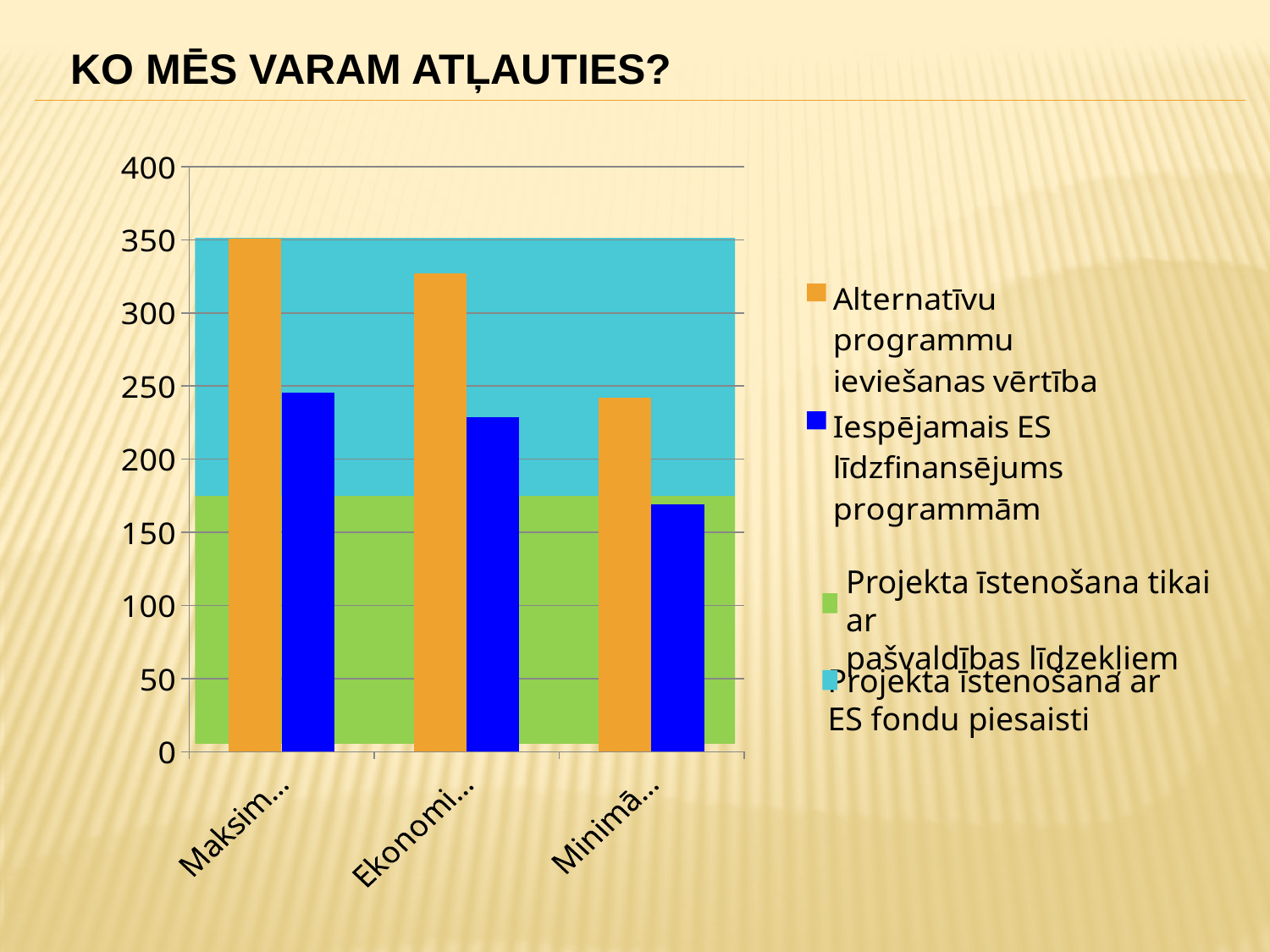
Is the blue bar for the rightmost category greater or less than 200? less Is the orange bar for the leftmost category greater or less than 300? greater How many entries does the chart legend list? 4 How many categories are shown along the x axis? 3 Is the blue bar for the middle category greater or less than 200? greater Do the orange bars rise or fall from left to right across the categories? fall What is the title of the slide containing the chart? KO MĒS VARAM ATĻAUTIES? For which category is the blue bar (Iespējamais ES līdzfinansējums programmām) the shortest? the rightmost category (Minimā...) What kind of chart is shown on the slide? bar chart In the leftmost category, which is larger: the orange bar or the blue bar? the orange bar For which category is the orange bar (Alternatīvu programmu ieviešanas vērtība) the tallest? the leftmost category (Maksim...)